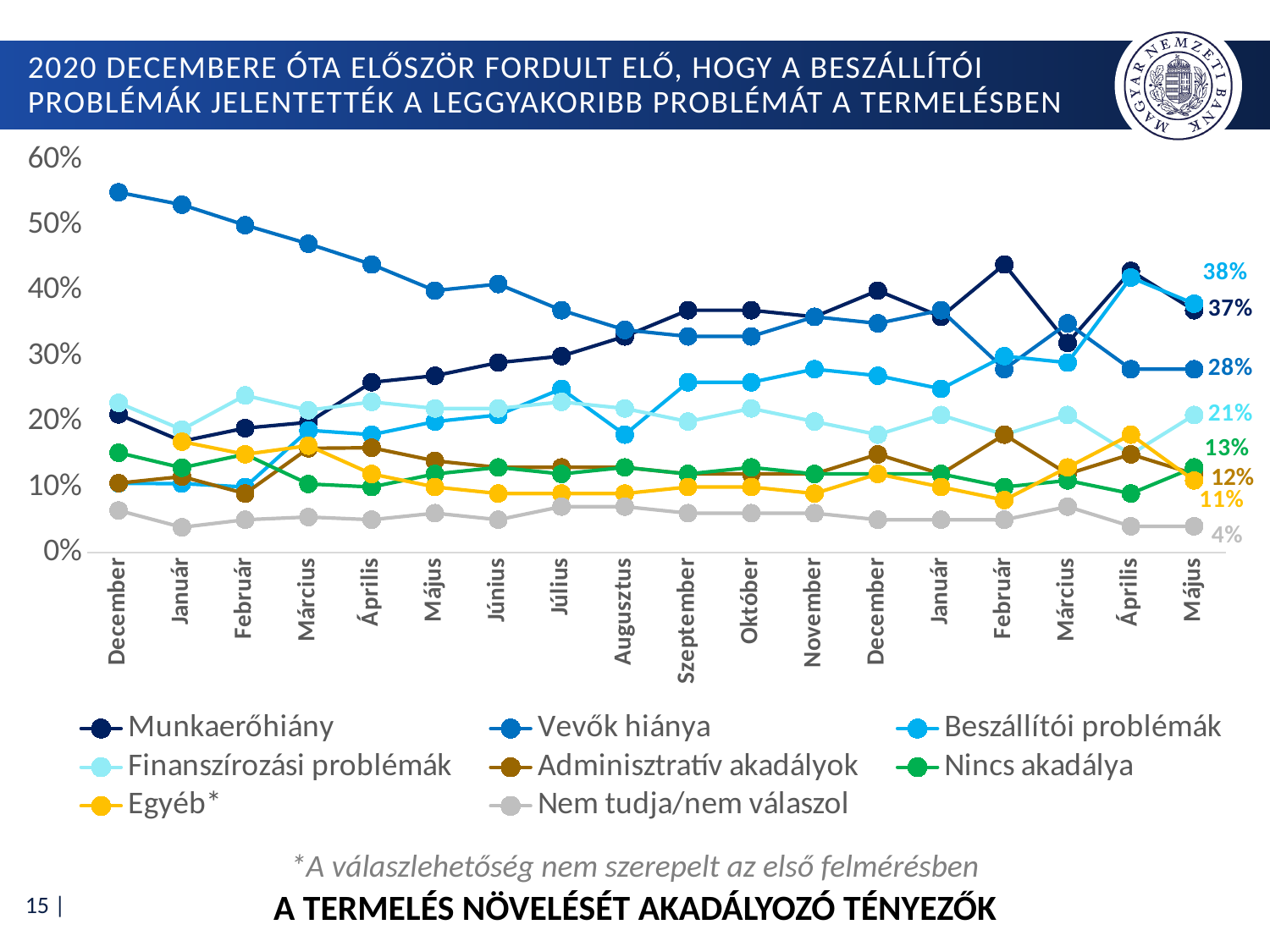
Is the value for Vevők hiánya at the first December greater or less than 50%? greater How many months are shown along the x axis? 18 What kind of chart is shown on the slide? Line chart Does the Vevők hiánya series rise or fall from the first December to the last Május? Fall What is the value for Beszállítói problémák at the last Május on the chart? 38% At the last Május, which is larger: Finanszírozási problémák or Nincs akadálya? Finanszírozási problémák What is the difference between Beszállítói problémák (38%) and Vevők hiánya (28%) at the last Május? 10 percentage points What is the value for Nem tudja/nem válaszol at the last Május on the chart? 4% What is the value for Vevők hiánya at the last Május on the chart? 28% What is the title of the chart shown at the bottom of the slide? A TERMELÉS NÖVELÉSÉT AKADÁLYOZÓ TÉNYEZŐK How many series does the legend list? 8 What is the value for Munkaerőhiány at the last Május on the chart? 37%